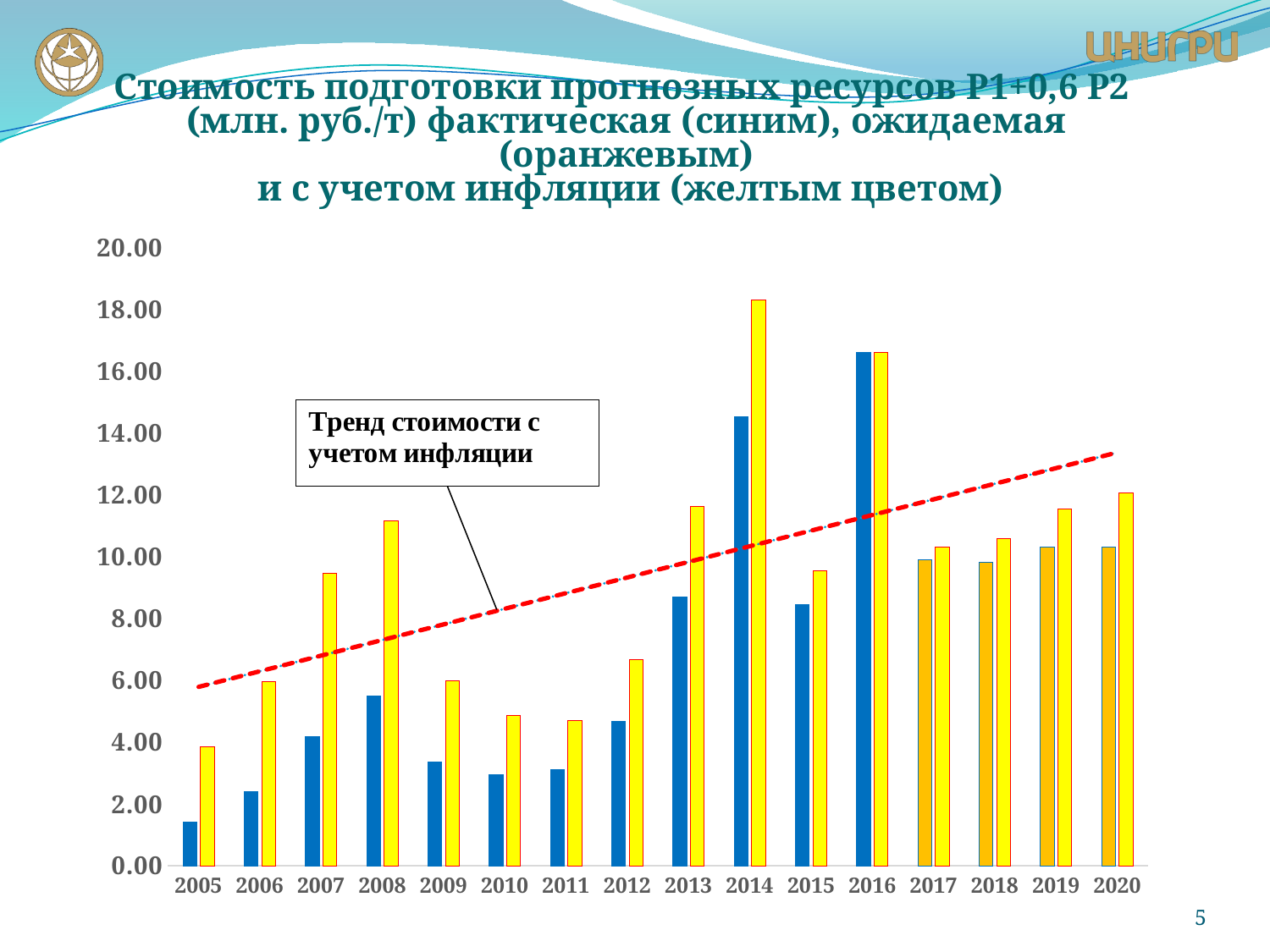
In which year is the blue (actual) bar the tallest? 2016 How many years are shown along the x axis of the chart? 16 Is the yellow bar for 2014 greater or less than 16.00? greater According to the title, which colour shows the expected (ожидаемая) cost? orange (оранжевым) Is the yellow bar for 2008 greater or less than 10.00? greater In which year is the yellow (inflation-adjusted) bar the tallest? 2014 Which is taller, the yellow bar for 2014 or the yellow bar for 2016? 2014 Does the red dashed trend line rise or fall from 2005 to 2020? rises In which year is the blue (actual) bar the shortest? 2005 What kind of chart is shown on the slide? bar chart Is the blue bar for 2005 greater or less than 2.00? less